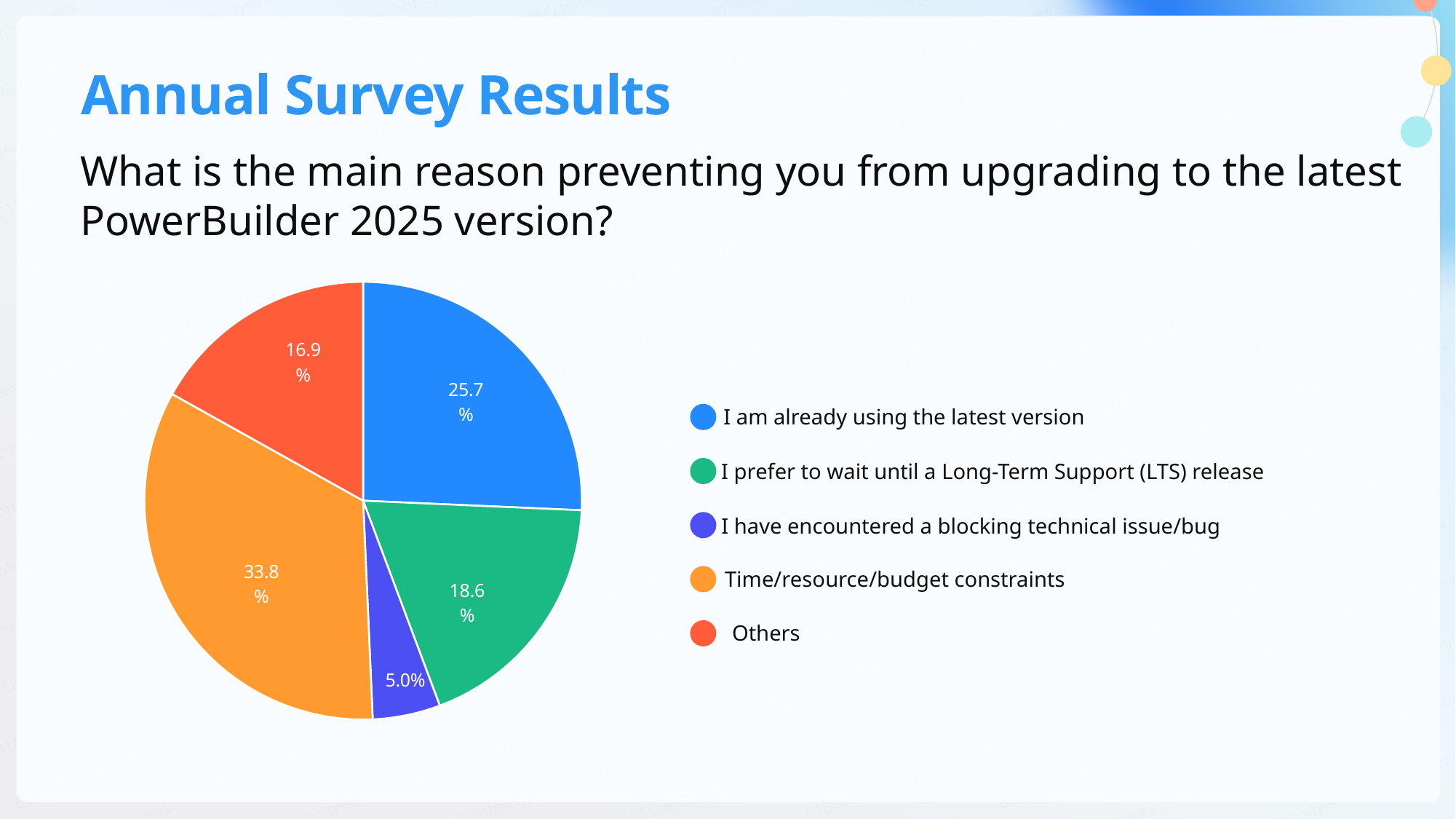
What share of respondents chose "I prefer to wait until a Long-Term Support (LTS) release"? 18.6% What share of respondents chose "I have encountered a blocking technical issue/bug"? 5.0% Which is larger: the share for "Others" or the share for "I prefer to wait until a Long-Term Support (LTS) release"? I prefer to wait until a Long-Term Support (LTS) release What share of respondents chose "Time/resource/budget constraints"? 33.8% What colour is the slice for "Others"? red What is the difference in percentage points between "Time/resource/budget constraints" and "I am already using the latest version"? 8.1 How many slices does the pie chart have? 5 What kind of chart is shown on the slide? pie chart What share of respondents chose "I am already using the latest version"? 25.7% What share of respondents chose "Others"? 16.9% Which reason has the smallest share of the pie? I have encountered a blocking technical issue/bug Which reason has the largest share of the pie? Time/resource/budget constraints